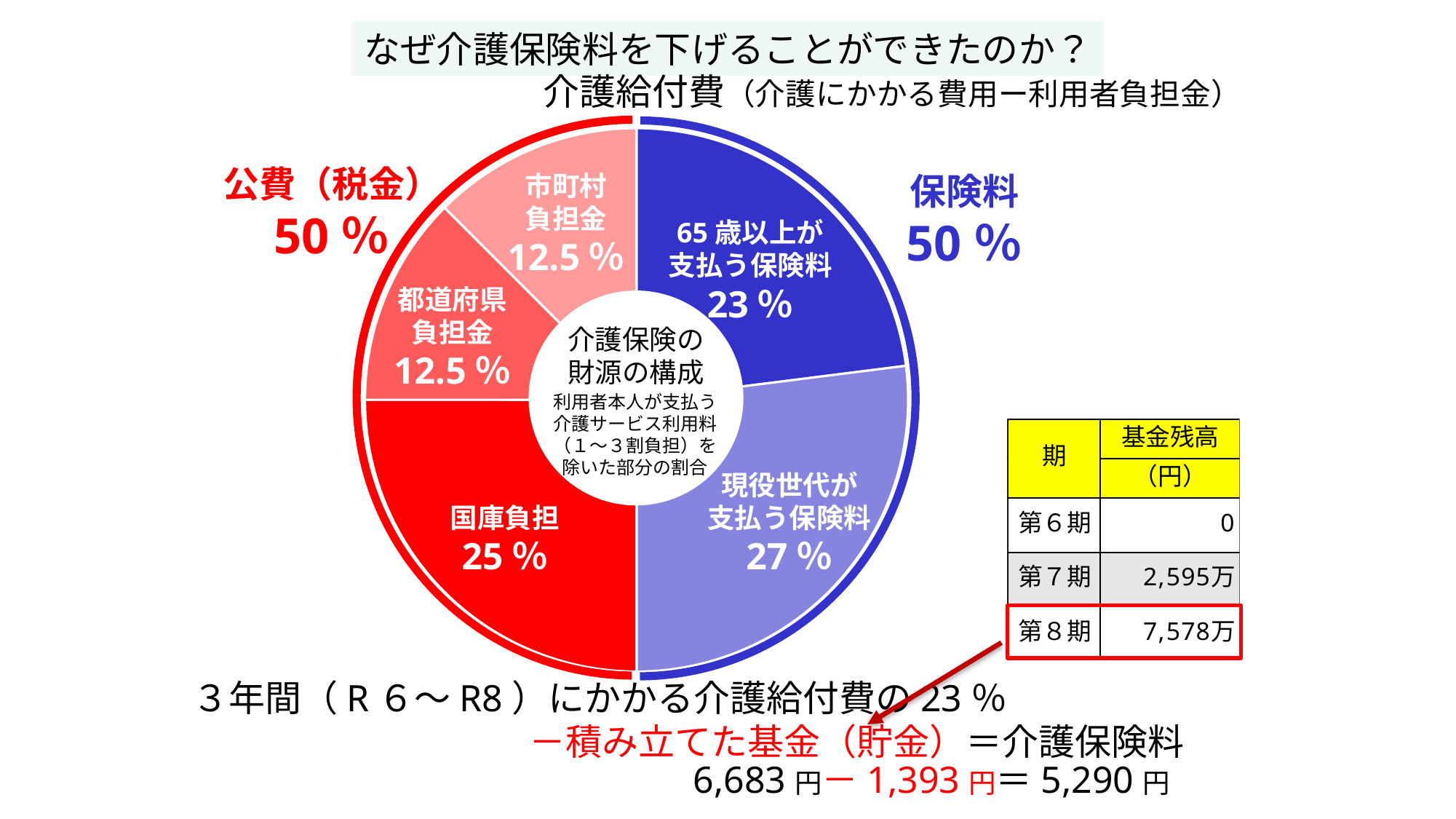
What percentage of the pie is 現役世代が支払う保険料? 27％ What kind of chart is shown on the slide? pie chart What percentage of the pie is 国庫負担? 25％ What percentage of the pie is 65歳以上が支払う保険料? 23％ What percentage of the pie is 都道府県負担金? 12.5％ Which is larger, 国庫負担 or 65歳以上が支払う保険料? 国庫負担 What is the combined share of 市町村負担金 and 都道府県負担金? 25％ How many slices does the pie chart have? 5 Which slice of the pie chart is the largest? 現役世代が支払う保険料 What is the combined share of the pie labelled 公費（税金）? 50％ What is the title shown in the centre of the pie chart? 介護保険の財源の構成 What is the difference in percentage points between 現役世代が支払う保険料 and 65歳以上が支払う保険料? 4％